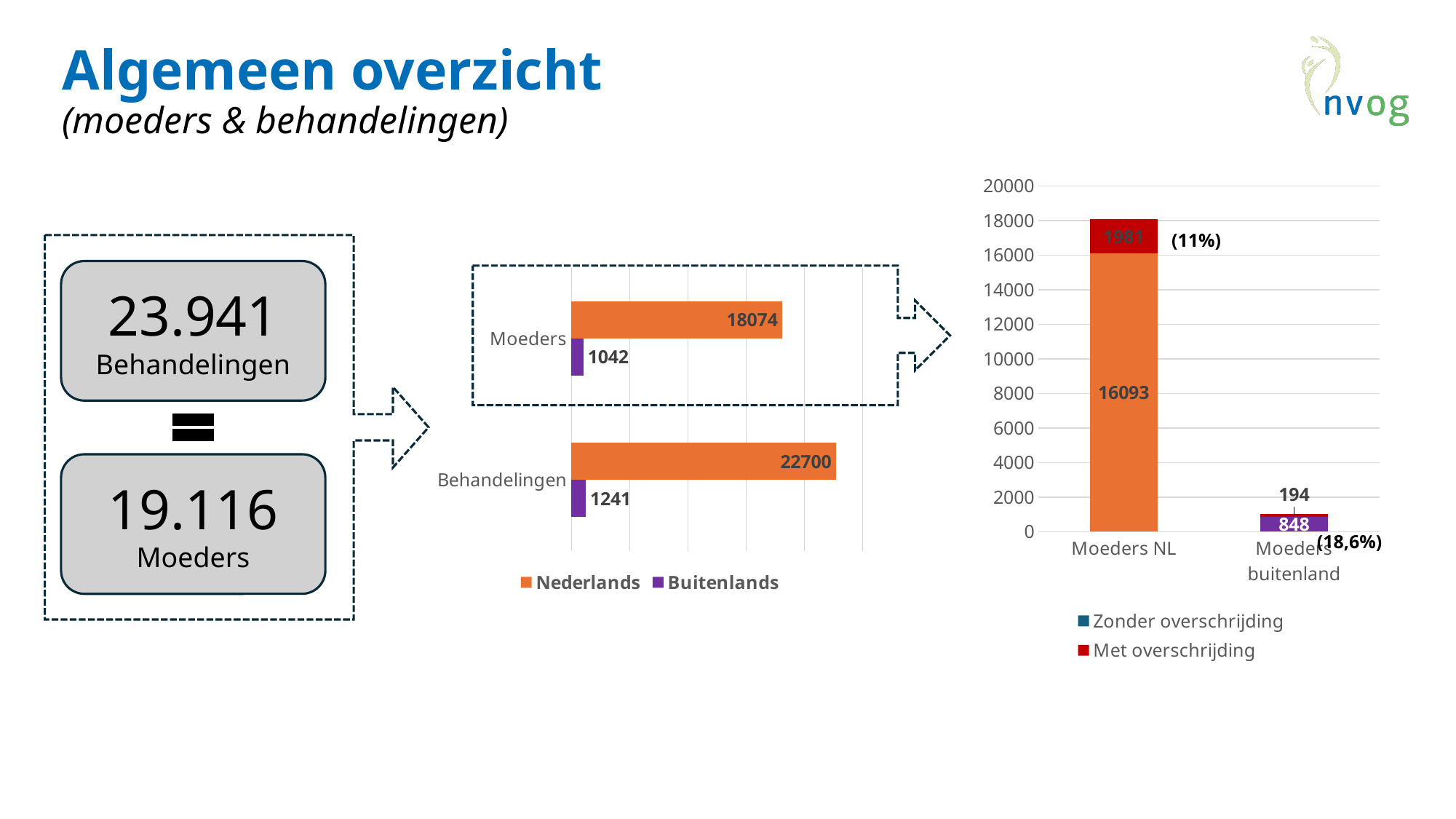
In the right-hand stacked bar chart, what is the total of the Moeders buitenland bar? 1042 In the right-hand stacked bar chart, what percentage is shown next to the Moeders buitenland bar? (18,6%) In the middle bar chart, how many series does the legend list? 2 In the right-hand stacked bar chart, what is the total of the Moeders NL bar? 18074 In the right-hand stacked bar chart, how many categories are shown on the x axis? 2 In the middle bar chart, what is the difference between the Nederlands values for Behandelingen and Moeders? 4626 In the right-hand stacked bar chart, what is the Zonder overschrijding value for Moeders buitenland? 848 In the right-hand stacked bar chart, what is the Met overschrijding value for Moeders NL? 1981 In the middle bar chart, what is the Nederlands value for Behandelingen? 22700 In the middle bar chart, what is the Buitenlands value for Moeders? 1042 In the middle bar chart, what kind of chart is shown? bar chart In the middle bar chart, which is larger: the Buitenlands value for Behandelingen or for Moeders? Behandelingen